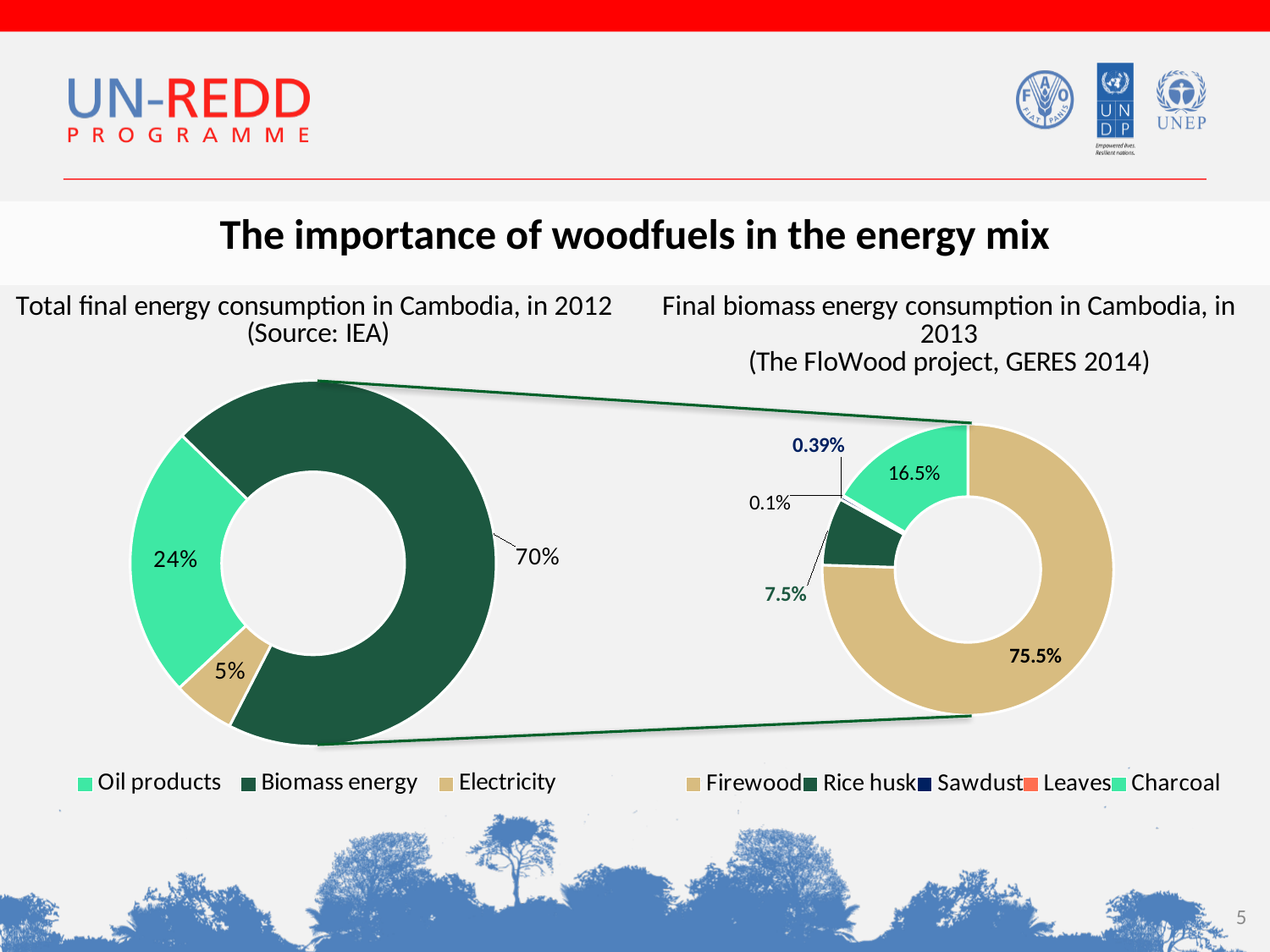
What type of chart is the left chart (Total final energy consumption in Cambodia, in 2012)? Doughnut (pie) chart In the left chart (Total final energy consumption in Cambodia, in 2012), which category has the smallest share? Electricity How many categories does the legend of the right chart (Final biomass energy consumption in Cambodia, in 2013) list? 5 In the right chart (Final biomass energy consumption in Cambodia, in 2013), what share is Rice husk? 7.5% In the left chart (Total final energy consumption in Cambodia, in 2012), what share is Oil products? 24% In the left chart (Total final energy consumption in Cambodia, in 2012), which category has the largest share? Biomass energy In the right chart (Final biomass energy consumption in Cambodia, in 2013), what share is Firewood? 75.5% In the left chart (Total final energy consumption in Cambodia, in 2012), what share is Biomass energy? 70% In the right chart (Final biomass energy consumption in Cambodia, in 2013), what share is Charcoal? 16.5% In the right chart (Final biomass energy consumption in Cambodia, in 2013), which is larger, Charcoal or Rice husk? Charcoal In the left chart (Total final energy consumption in Cambodia, in 2012), how many percentage points larger is Biomass energy than Oil products? 46 percentage points In the left chart (Total final energy consumption in Cambodia, in 2012), what share is Electricity? 5%